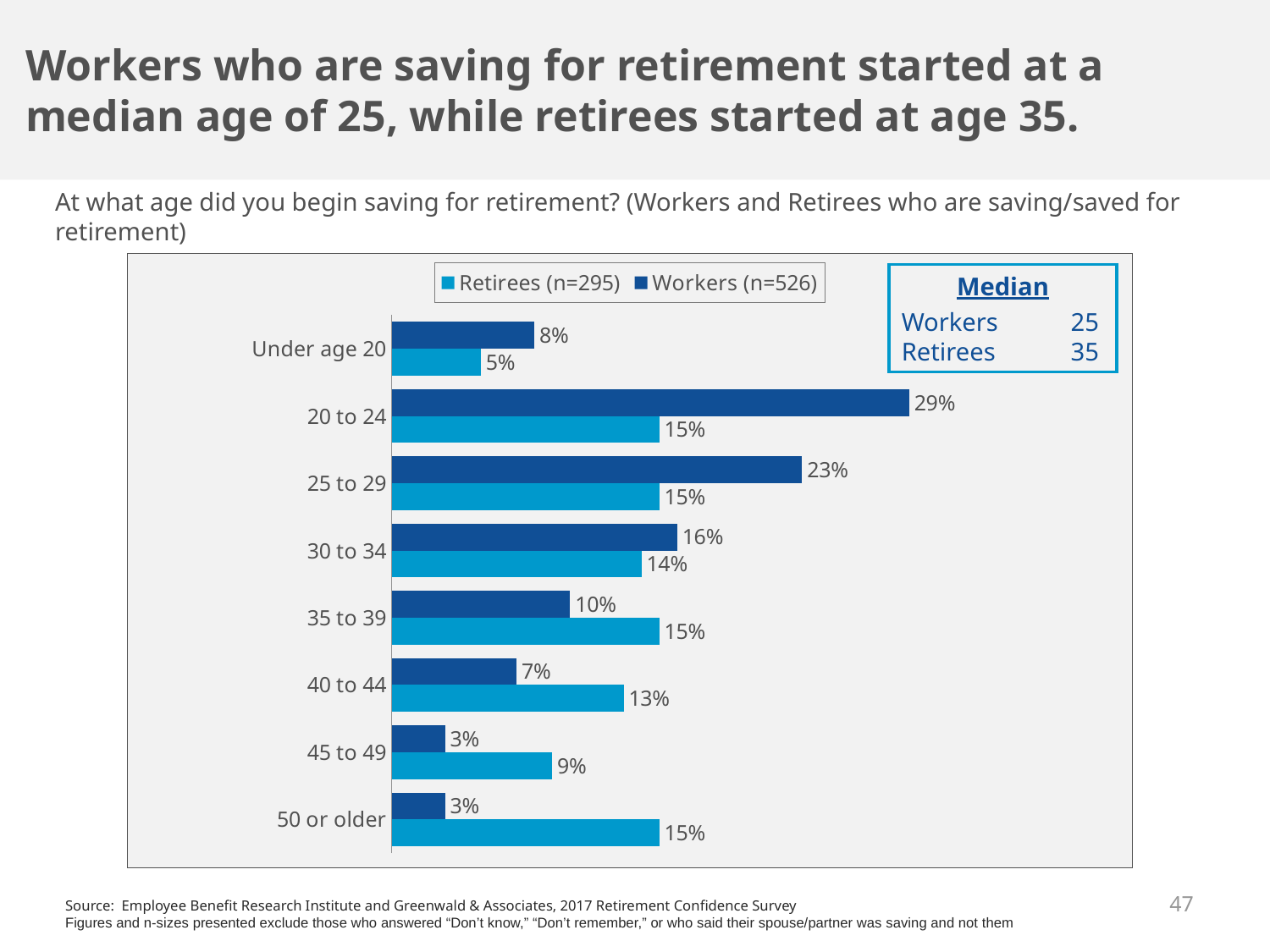
What percentage of Workers began saving for retirement at age 20 to 24? 29% What percentage of Retirees began saving for retirement at age 50 or older? 15% What is the difference between the Workers and Retirees values for the 20 to 24 age category? 14 percentage points How many series does the legend list? 2 According to the Median box, what is the median age at which Retirees started saving? 35 What is the sample size (n) for Retirees shown in the legend? 295 For the 40 to 44 age category, which is larger: the Workers value or the Retirees value? Retirees Which age category has the lowest value for Retirees? Under age 20 What kind of chart is shown on the slide? Bar chart Which age category has the highest value for Workers? 20 to 24 How many age categories are shown in the chart? 8 What percentage of Workers began saving for retirement under age 20? 8%